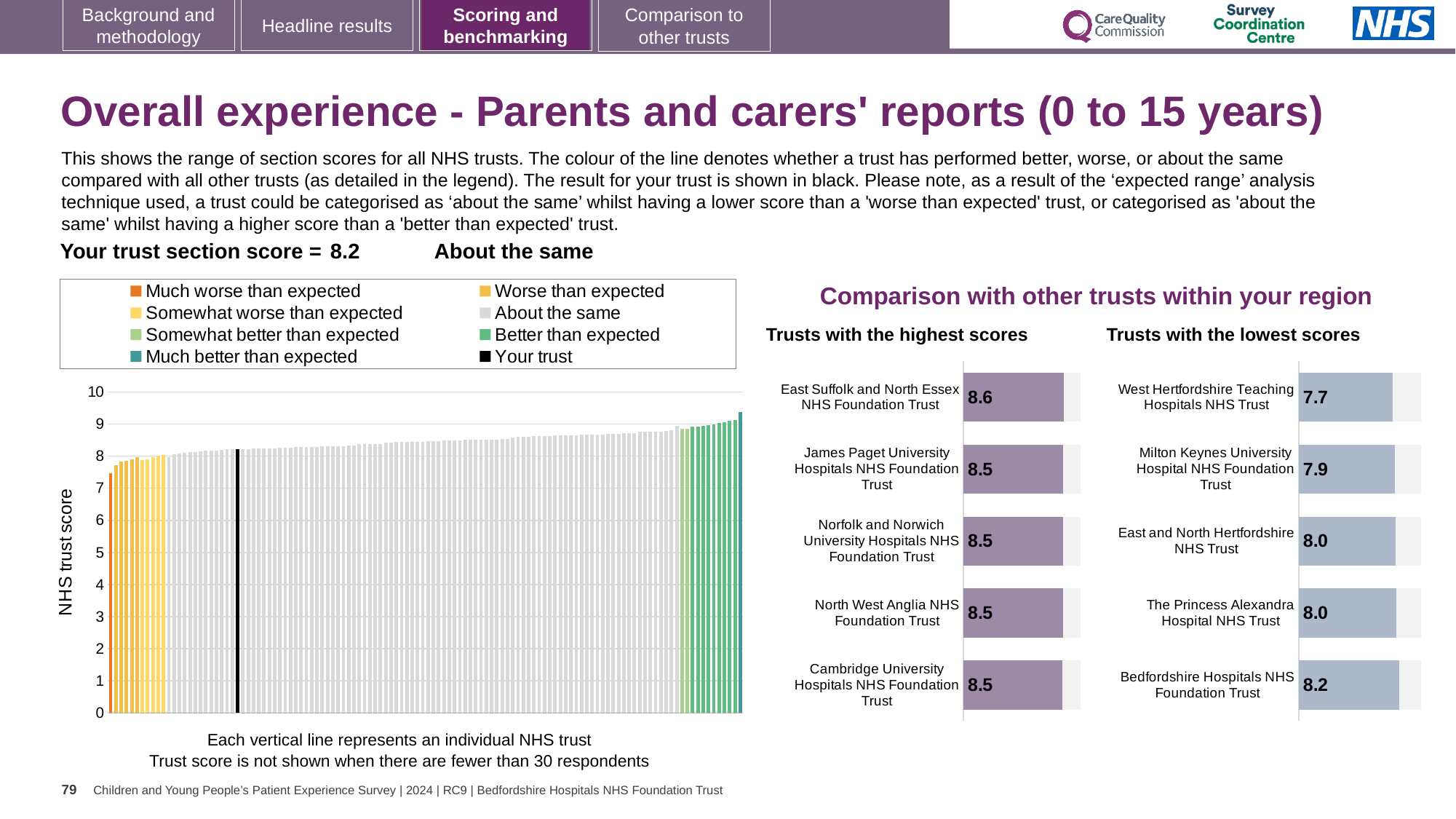
In the 'Trusts with the lowest scores' chart, which trust has the lowest score? West Hertfordshire Teaching Hospitals NHS Trust In the 'Trusts with the highest scores' chart, what is the score for East Suffolk and North Essex NHS Foundation Trust? 8.6 In the NHS trust score chart on the left, is the value of the black 'Your trust' bar greater or less than 5? greater How many trusts are listed in the 'Trusts with the highest scores' chart? 5 How many entries does the legend of the NHS trust score chart on the left list? 8 What is the title above the two bar charts on the right of the slide? Comparison with other trusts within your region In the 'Trusts with the lowest scores' chart, which has the larger score: Milton Keynes University Hospital NHS Foundation Trust or Bedfordshire Hospitals NHS Foundation Trust? Bedfordshire Hospitals NHS Foundation Trust In the 'Trusts with the lowest scores' chart, what is the difference between the scores of Bedfordshire Hospitals NHS Foundation Trust and West Hertfordshire Teaching Hospitals NHS Trust? 0.5 In the 'Trusts with the highest scores' chart, which trust has the highest score? East Suffolk and North Essex NHS Foundation Trust What kind of chart is the NHS trust score chart on the left of the slide? Bar chart In the 'Trusts with the lowest scores' chart, what is the score for West Hertfordshire Teaching Hospitals NHS Trust? 7.7 In the NHS trust score chart on the left, do the values rise or fall from left to right? Rise